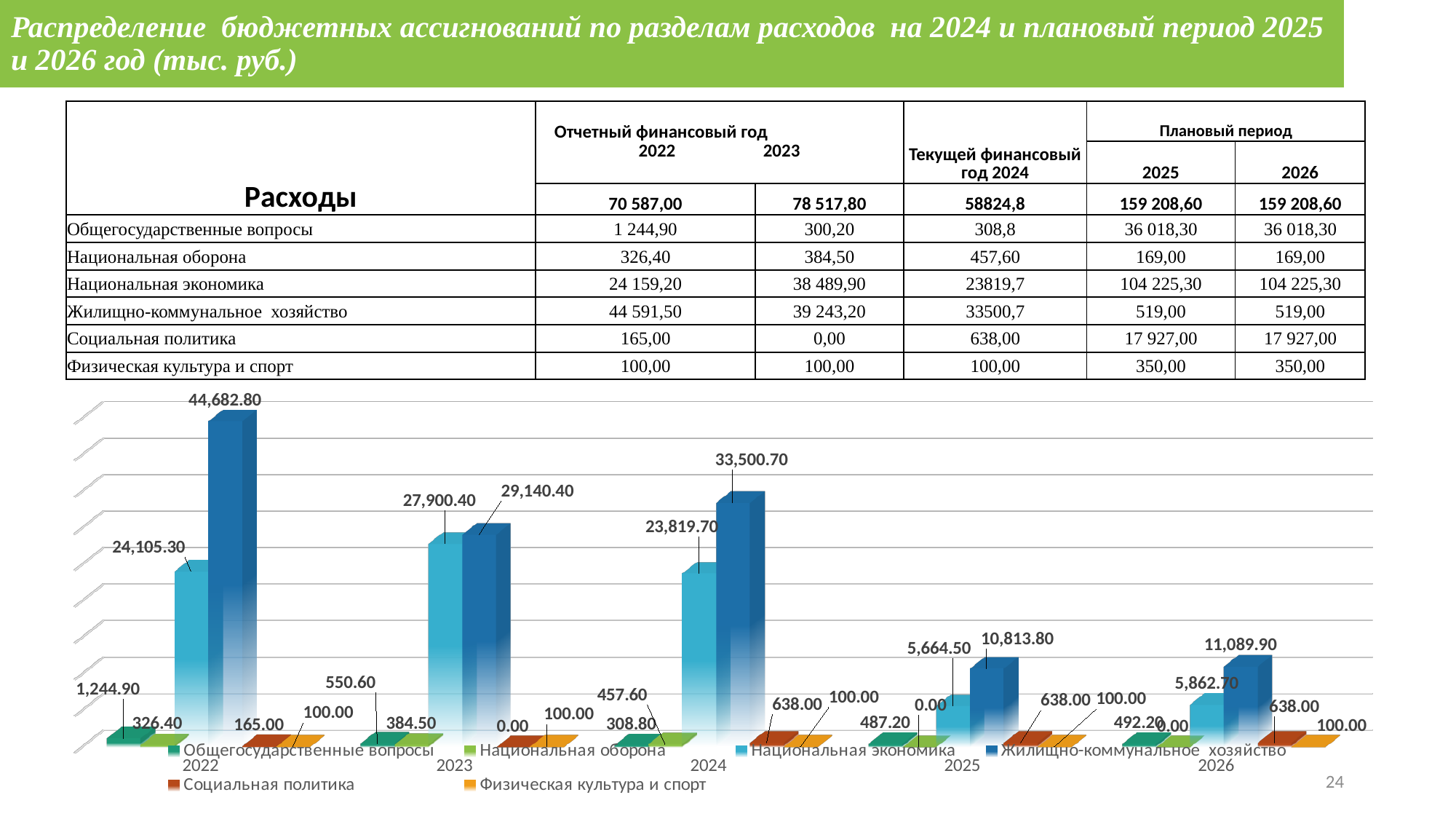
How many year categories are shown along the x axis of the chart? 5 In the chart, which year has the lowest value for Жилищно-коммунальное хозяйство? 2025 In the chart, what is the value labelled for Национальная экономика in 2024? 23,819.70 In the chart, what is the value labelled for Жилищно-коммунальное хозяйство in 2022? 44,682.80 In the chart, what colour represents Физическая культура и спорт in the legend? Orange In the chart, which year has the highest value for Жилищно-коммунальное хозяйство? 2022 How many series does the chart's legend list? 6 In the chart, by how much does the Жилищно-коммунальное хозяйство value in 2026 exceed the value in 2025? 276.10 What type of chart is shown below the table on the slide? Bar chart In the chart, which is larger in 2023: Национальная экономика or Жилищно-коммунальное хозяйство? Жилищно-коммунальное хозяйство In the chart, what is the difference between the 2022 values for Жилищно-коммунальное хозяйство and Национальная экономика? 20,577.50 In the chart, what is the value labelled for Социальная политика in 2023? 0.00